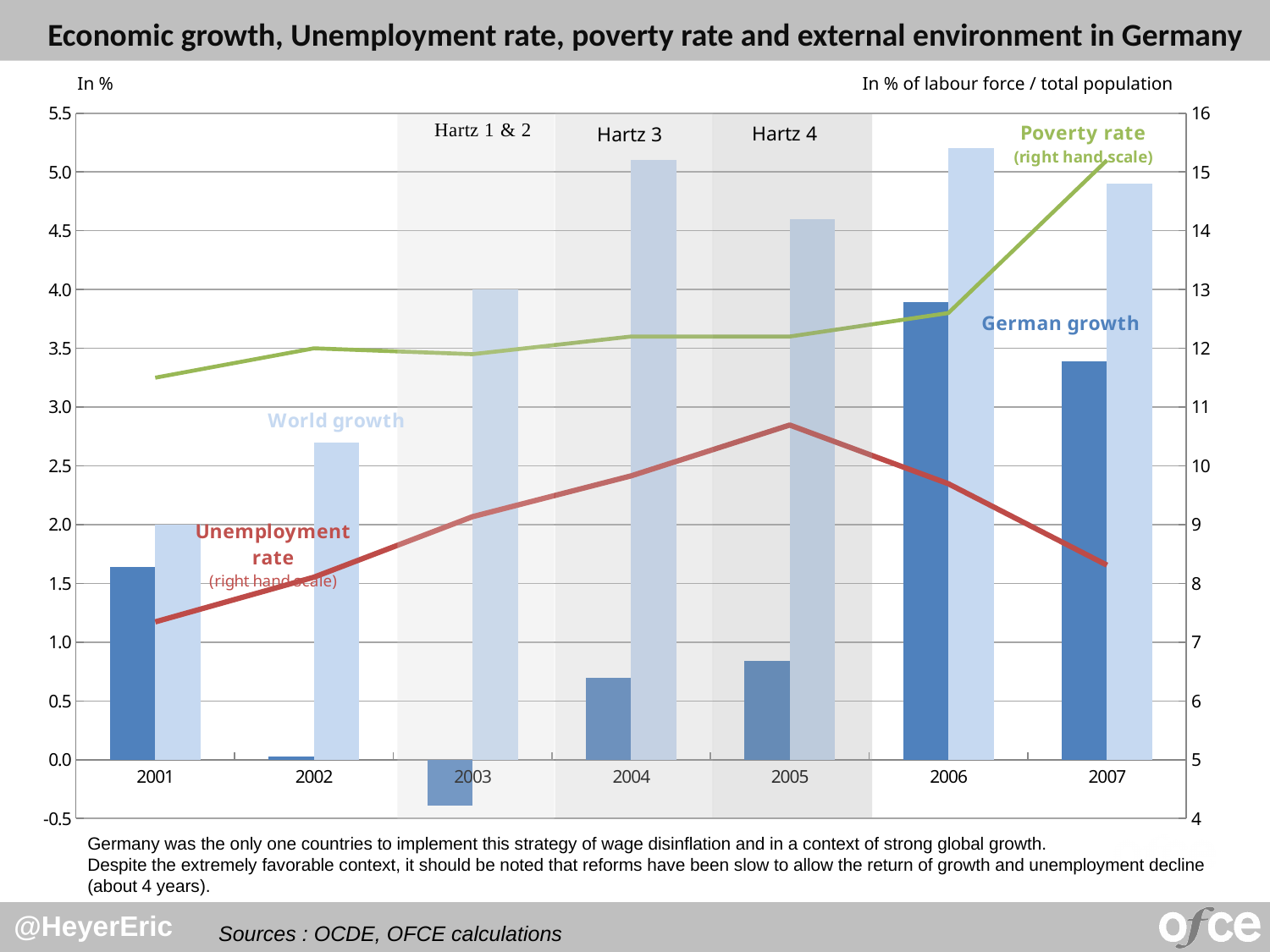
In which year is world growth lowest? 2001 In which year is German growth highest? 2006 Is German growth in 2006 greater or less than 3.5? greater In which year is the poverty rate highest? 2007 Does the unemployment rate rise or fall from 2005 to 2007? Fall Is the unemployment rate in 2005 greater or less than 10 on the right-hand scale? greater How many years are shown on the x axis? 7 In which year does the unemployment rate reach its peak? 2005 Is the poverty rate in 2001 greater or less than 12 on the right-hand scale? less What kind of chart is this? Combined bar and line chart Which is larger in 2007, German growth or world growth? World growth In which year is German growth lowest? 2003